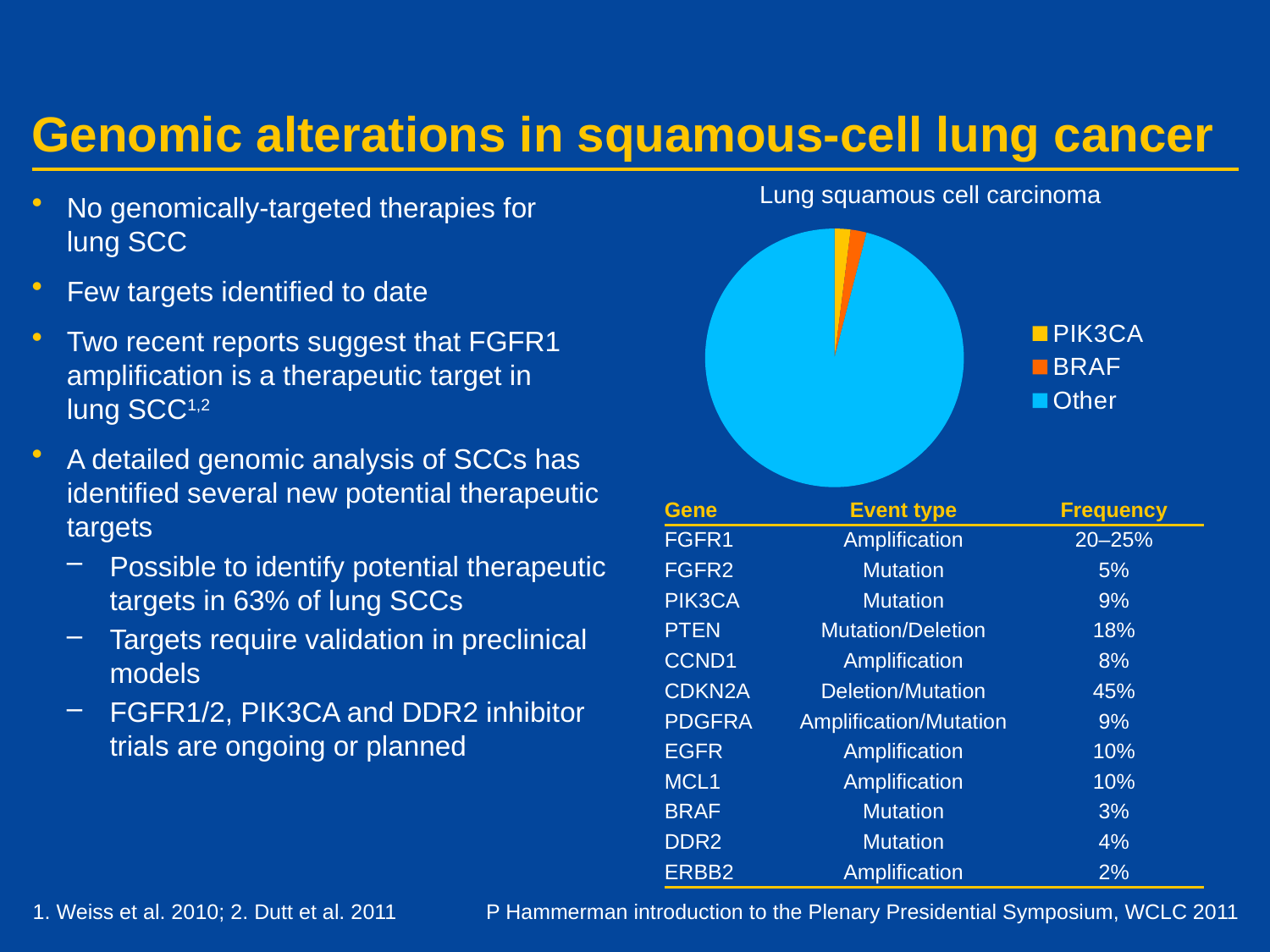
In the pie chart, which slice is larger, Other or BRAF? Other How many slices does the pie chart have? 3 How many entries does the pie chart's legend list? 3 What colour is the Other slice in the pie chart? light blue What kind of chart is shown on the slide? pie chart What is the title of the pie chart? Lung squamous cell carcinoma In the pie chart, which slice is larger, Other or PIK3CA? Other Which slice of the pie chart is the largest? Other